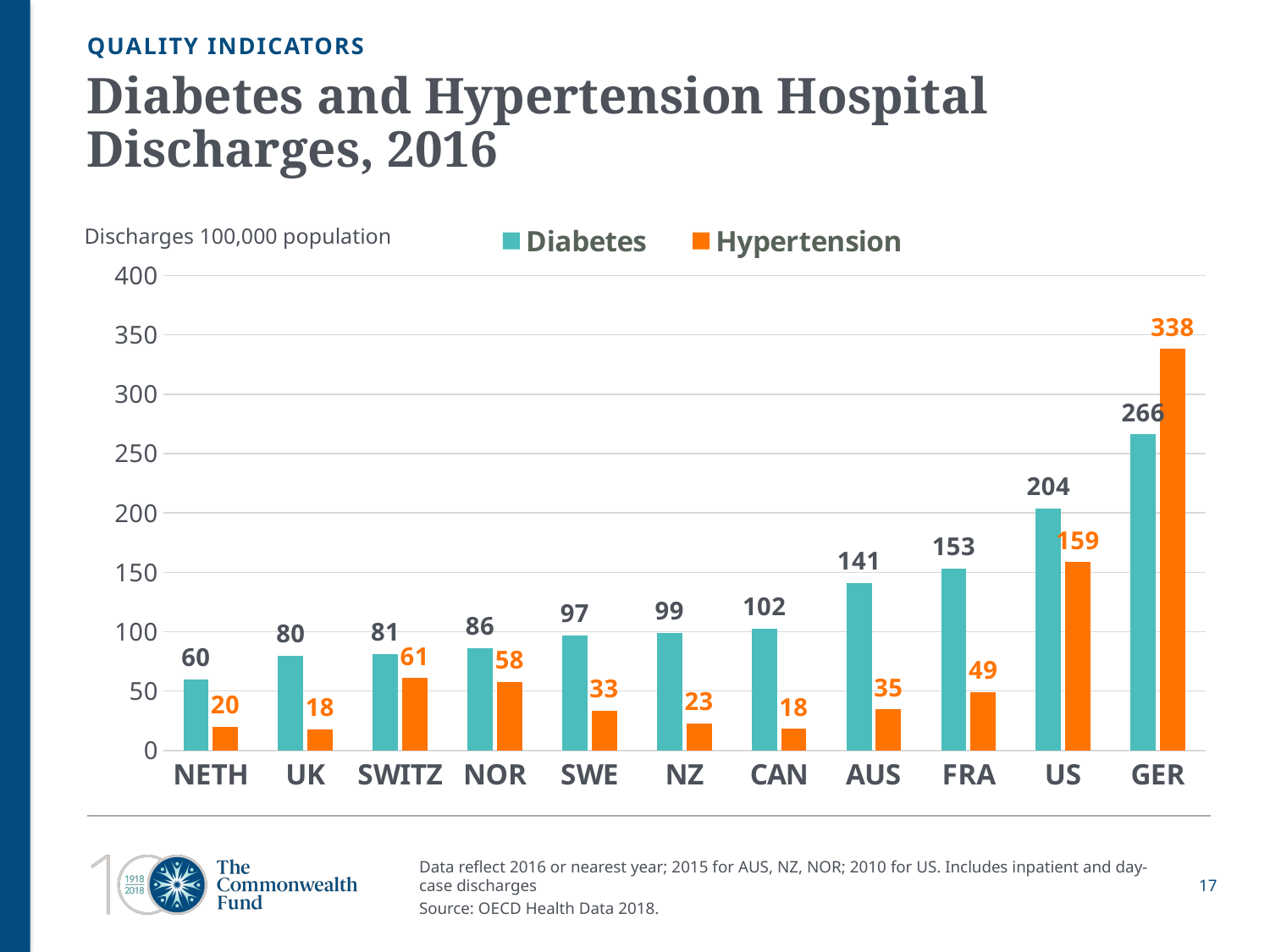
How many series does the legend list? 2 What is the Hypertension discharge value for Germany (GER)? 338 How many countries are shown on the x axis? 11 What kind of chart is shown on the slide? Bar chart Which country has the highest Diabetes discharge value? GER Do the Diabetes values rise or fall from NETH to GER along the x axis? Rise Which country has the lowest Diabetes discharge value? NETH Which is larger, the Hypertension value for the US or the Diabetes value for Australia (AUS)? Hypertension value for the US What is the difference between the Diabetes and Hypertension values for France (FRA)? 104 What is the Hypertension value for Switzerland (SWITZ)? 61 What is the Diabetes discharge value for the US? 204 Is the Diabetes value for Germany (GER) greater or less than 250? greater